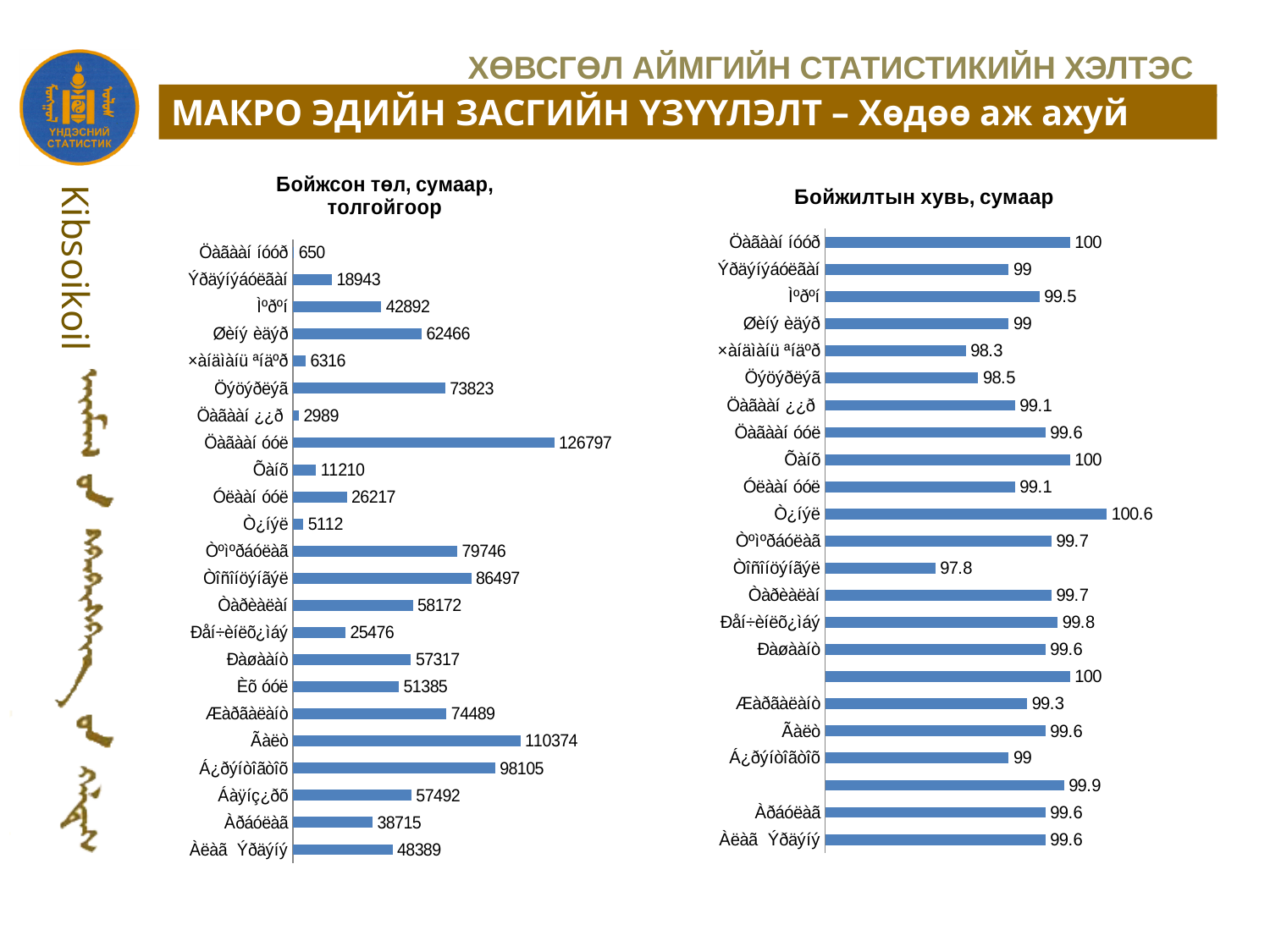
How many bars are plotted in the left chart ("Бойжсон төл, сумаар, толгойгоор")? 23 In the right chart ("Бойжилтын хувь, сумаар"), what is the value of the bottom bar? 99.6 In the left chart ("Бойжсон төл, сумаар, толгойгоор"), what is the value of the bottom bar? 48389 In the left chart ("Бойжсон төл, сумаар, толгойгоор"), what is the highest value shown? 126797 In the right chart ("Бойжилтын хувь, сумаар"), what is the lowest value shown? 97.8 In the right chart ("Бойжилтын хувь, сумаар"), what is the highest value shown? 100.6 What is the title of the chart on the right side of the slide? Бойжилтын хувь, сумаар In the left chart ("Бойжсон төл, сумаар, толгойгоор"), what is the difference between the highest value (126797) and the second-highest value (110374)? 16423 In the left chart ("Бойжсон төл, сумаар, толгойгоор"), what is the value of the topmost bar? 650 What type of chart is the left chart titled "Бойжсон төл, сумаар, толгойгоор"? bar chart In the left chart ("Бойжсон төл, сумаар, толгойгоор"), what is the lowest value shown? 650 In the right chart ("Бойжилтын хувь, сумаар"), what is the value of the topmost bar? 100